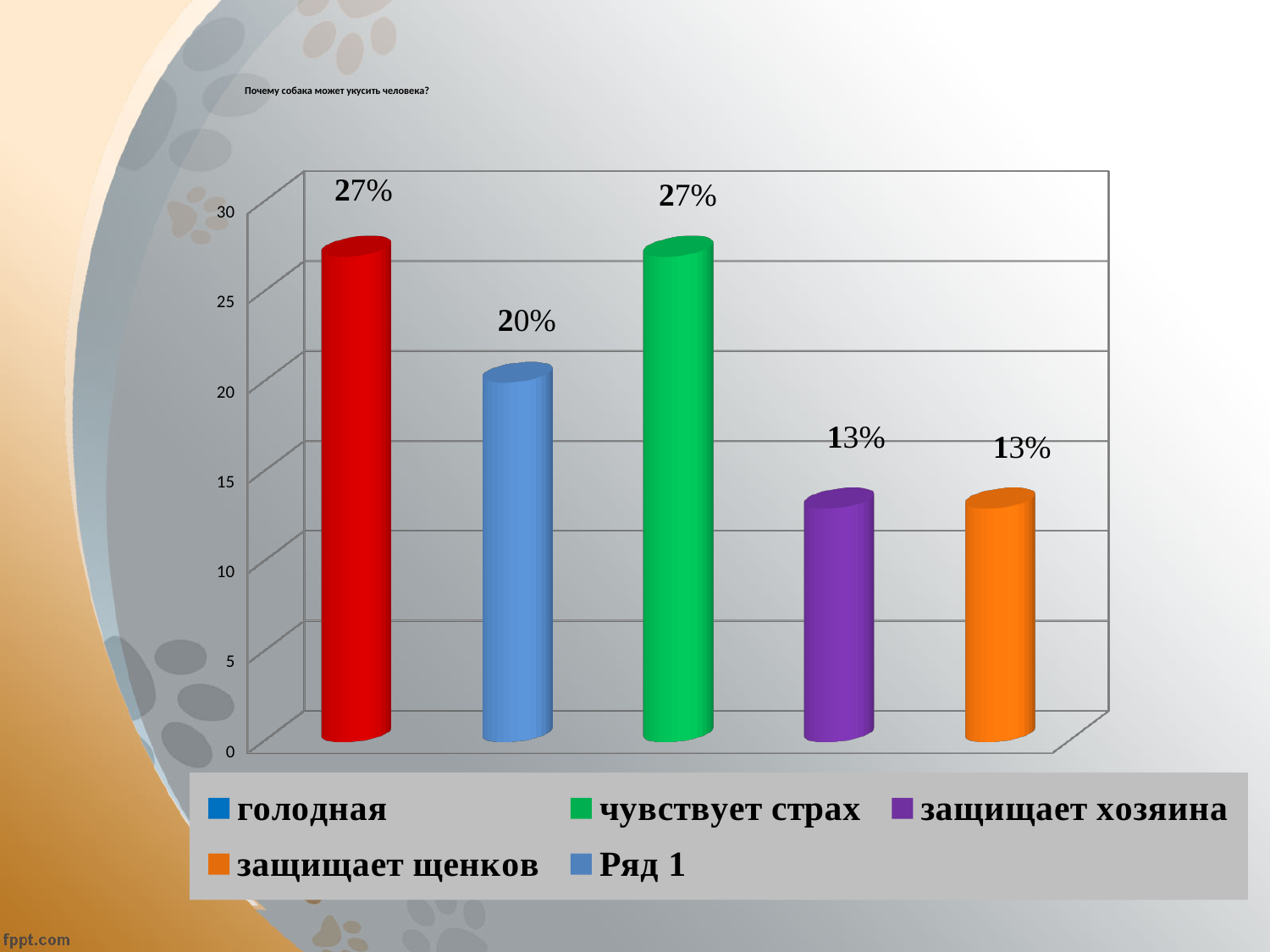
Is the value of the blue bar greater or less than 15? greater What value is labelled on the blue bar? 20% What is the value for "защищает щенков"? 13% How many entries does the legend list? 5 What is the value for "чувствует страх"? 27% How many bars are plotted in the chart? 5 Which is larger, the value for "чувствует страх" or the value for "защищает хозяина"? чувствует страх What value is labelled on the red bar? 27% What is the title of the chart? Почему собака может укусить человека? What is the difference between the values for "чувствует страх" and "защищает хозяина"? 14% What kind of chart is shown on the slide? bar chart What is the value for "защищает хозяина"? 13%